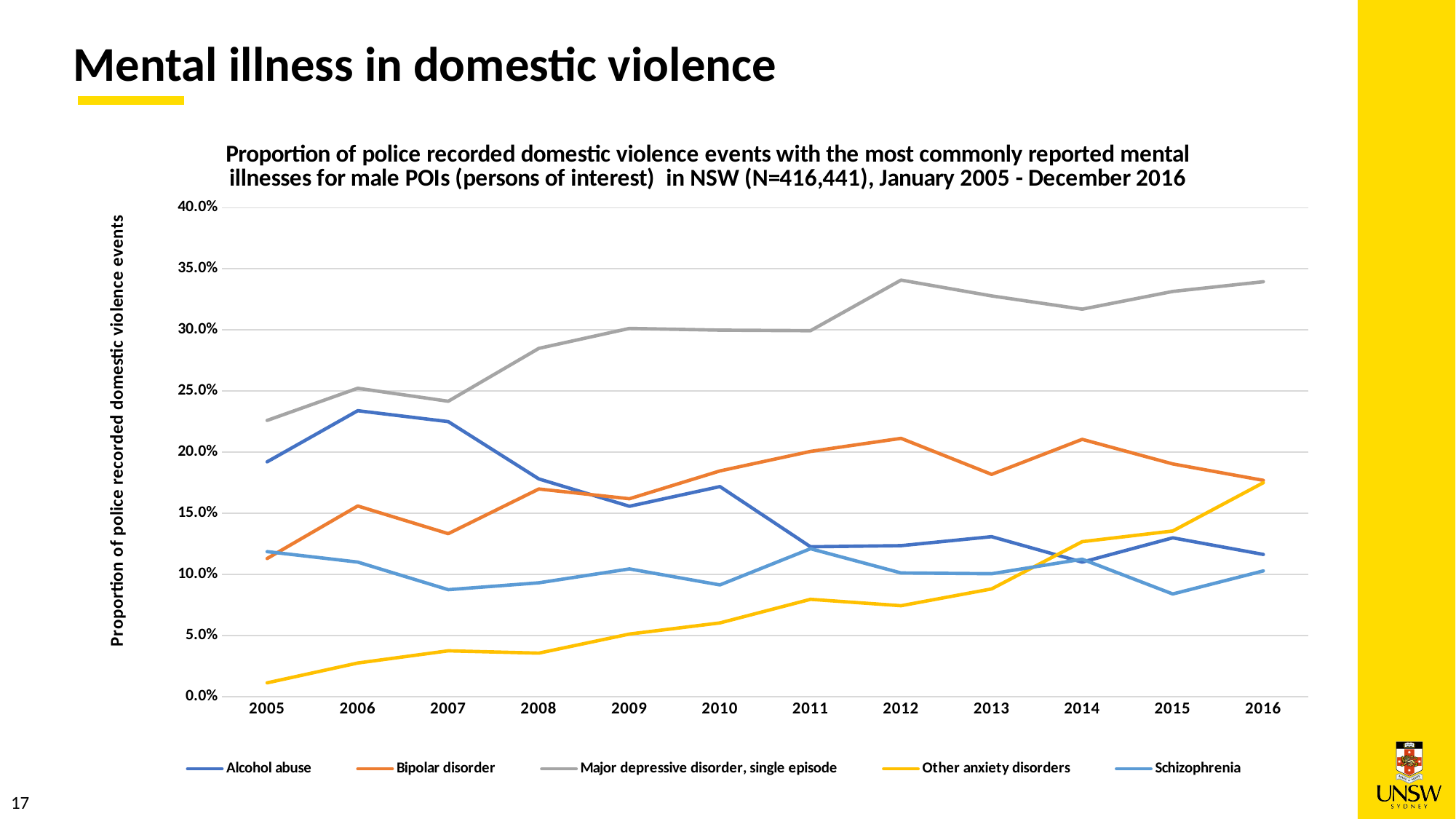
Is the value for Other anxiety disorders in 2005 greater or less than 5.0%? less Does the proportion for Alcohol abuse rise or fall from 2006 to 2011? fall Is the value for Bipolar disorder in 2007 greater or less than 15.0%? less In 2010, which is larger: the value for Alcohol abuse or the value for Schizophrenia? Alcohol abuse Is the value for Major depressive disorder, single episode in 2012 greater or less than 30.0%? greater What colour is the line for Major depressive disorder, single episode? grey Which mental illness has the lowest proportion in 2005? Other anxiety disorders What kind of chart is shown on the slide? line chart Does the proportion for Other anxiety disorders rise or fall from 2005 to 2016? rise How many years are shown along the x axis? 12 How many series does the legend list? 5 Which mental illness has the highest proportion in 2016? Major depressive disorder, single episode